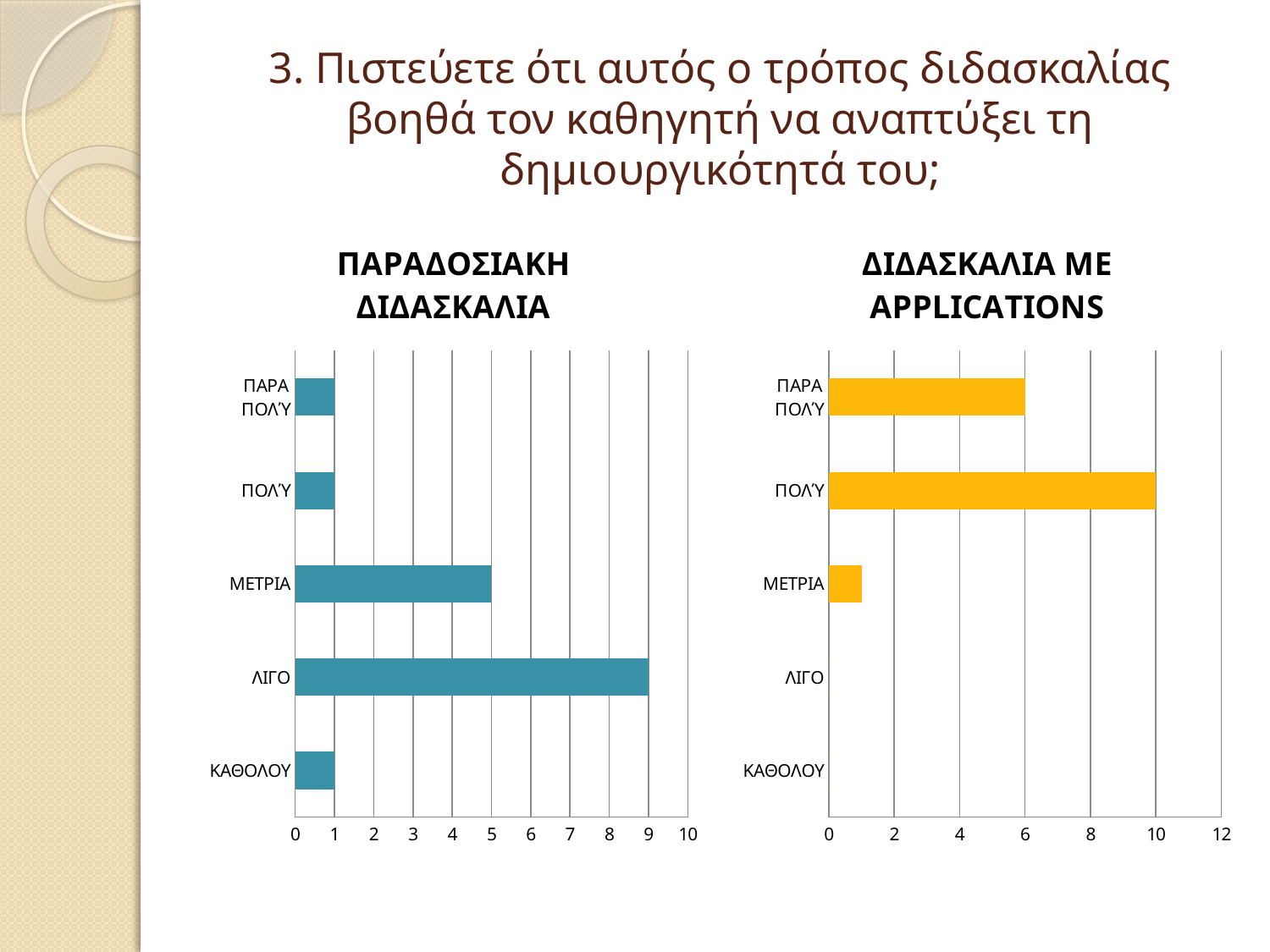
In the ΠΑΡΑΔΟΣΙΑΚΗ ΔΙΔΑΣΚΑΛΙΑ chart, what is the difference between the values for ΛΙΓΟ and ΜΕΤΡΙΑ? 4 In the ΔΙΔΑΣΚΑΛΙΑ ΜΕ APPLICATIONS chart, is the value for ΜΕΤΡΙΑ greater or less than 2? less In the ΠΑΡΑΔΟΣΙΑΚΗ ΔΙΔΑΣΚΑΛΙΑ chart, what is the value for ΜΕΤΡΙΑ? 5 What kind of chart is the ΔΙΔΑΣΚΑΛΙΑ ΜΕ APPLICATIONS chart? bar chart In the ΠΑΡΑΔΟΣΙΑΚΗ ΔΙΔΑΣΚΑΛΙΑ chart, which category has the highest value? ΛΙΓΟ In the ΔΙΔΑΣΚΑΛΙΑ ΜΕ APPLICATIONS chart, what is the difference between the values for ΠΟΛΎ and ΠΑΡΑ ΠΟΛΎ? 4 In the ΔΙΔΑΣΚΑΛΙΑ ΜΕ APPLICATIONS chart, what is the value for ΠΟΛΎ? 10 In the ΔΙΔΑΣΚΑΛΙΑ ΜΕ APPLICATIONS chart, which category has the highest value? ΠΟΛΎ In the ΔΙΔΑΣΚΑΛΙΑ ΜΕ APPLICATIONS chart, what is the value for ΠΑΡΑ ΠΟΛΎ? 6 Which chart has the larger value for ΠΟΛΎ, ΠΑΡΑΔΟΣΙΑΚΗ ΔΙΔΑΣΚΑΛΙΑ or ΔΙΔΑΣΚΑΛΙΑ ΜΕ APPLICATIONS? ΔΙΔΑΣΚΑΛΙΑ ΜΕ APPLICATIONS In the ΠΑΡΑΔΟΣΙΑΚΗ ΔΙΔΑΣΚΑΛΙΑ chart, what is the value for ΛΙΓΟ? 9 How many categories are shown in the ΠΑΡΑΔΟΣΙΑΚΗ ΔΙΔΑΣΚΑΛΙΑ chart? 5